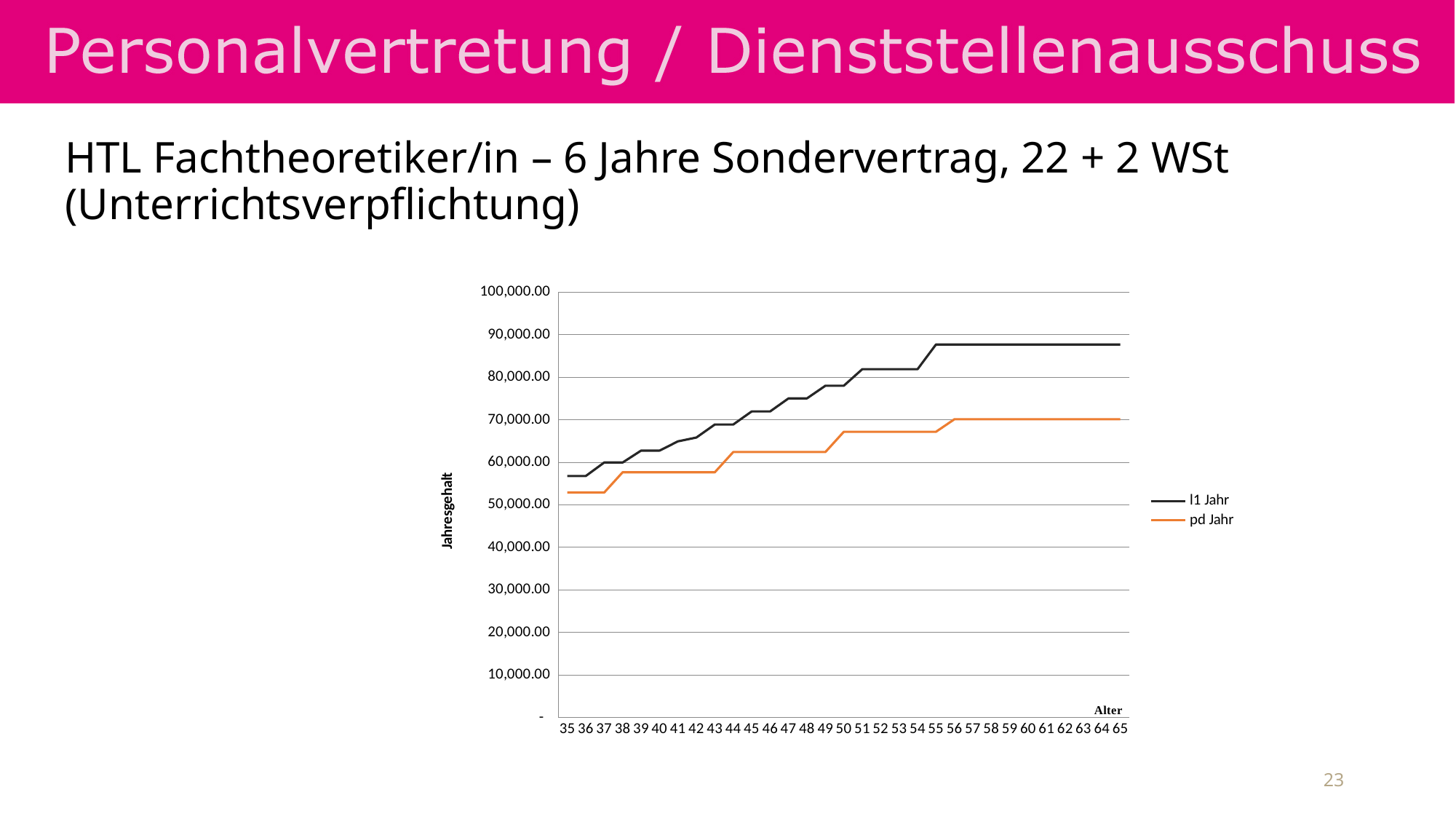
What kind of chart is shown on the slide? line chart How many age values are shown along the x axis? 31 How many series does the legend list? 2 Do the values of the l1 Jahr series rise or fall as age increases? rise At age 65, which series has the higher value, l1 Jahr or pd Jahr? l1 Jahr Which two series are listed in the legend? l1 Jahr and pd Jahr Is the value for l1 Jahr at age 65 greater or less than 80,000.00? greater Is the value for pd Jahr at age 40 greater or less than 60,000.00? less Is the value for pd Jahr at age 35 greater or less than 50,000.00? greater What is the label of the vertical axis? Jahresgehalt